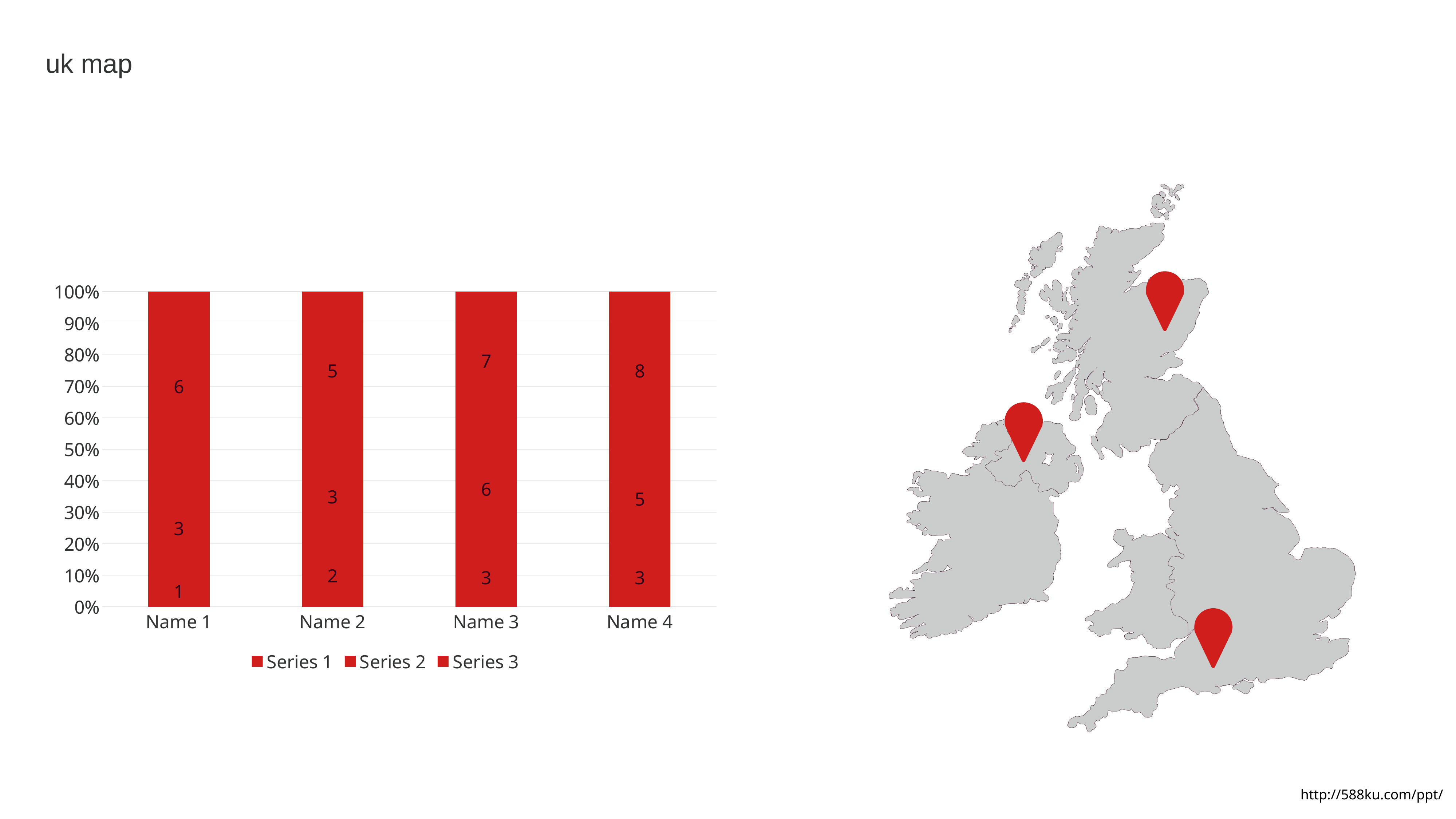
What is the total of the three values in the Name 3 bar? 16 What type of chart is shown on the slide? stacked bar chart What is the value of the middle segment of the Name 3 bar? 6 What is the total of the three values in the Name 1 bar? 10 What is the value of the bottom segment of the Name 1 bar? 1 Which is larger, the middle segment value of Name 3 or the middle segment value of Name 2? Name 3 What is the difference between the top segment values of Name 4 and Name 1? 2 What is the value of the bottom segment of the Name 2 bar? 2 How many categories are shown on the x axis of the chart? 4 What is the value of the top segment of the Name 4 bar? 8 What are the names of the series listed in the chart legend? Series 1, Series 2, Series 3 How many series does the chart legend list? 3